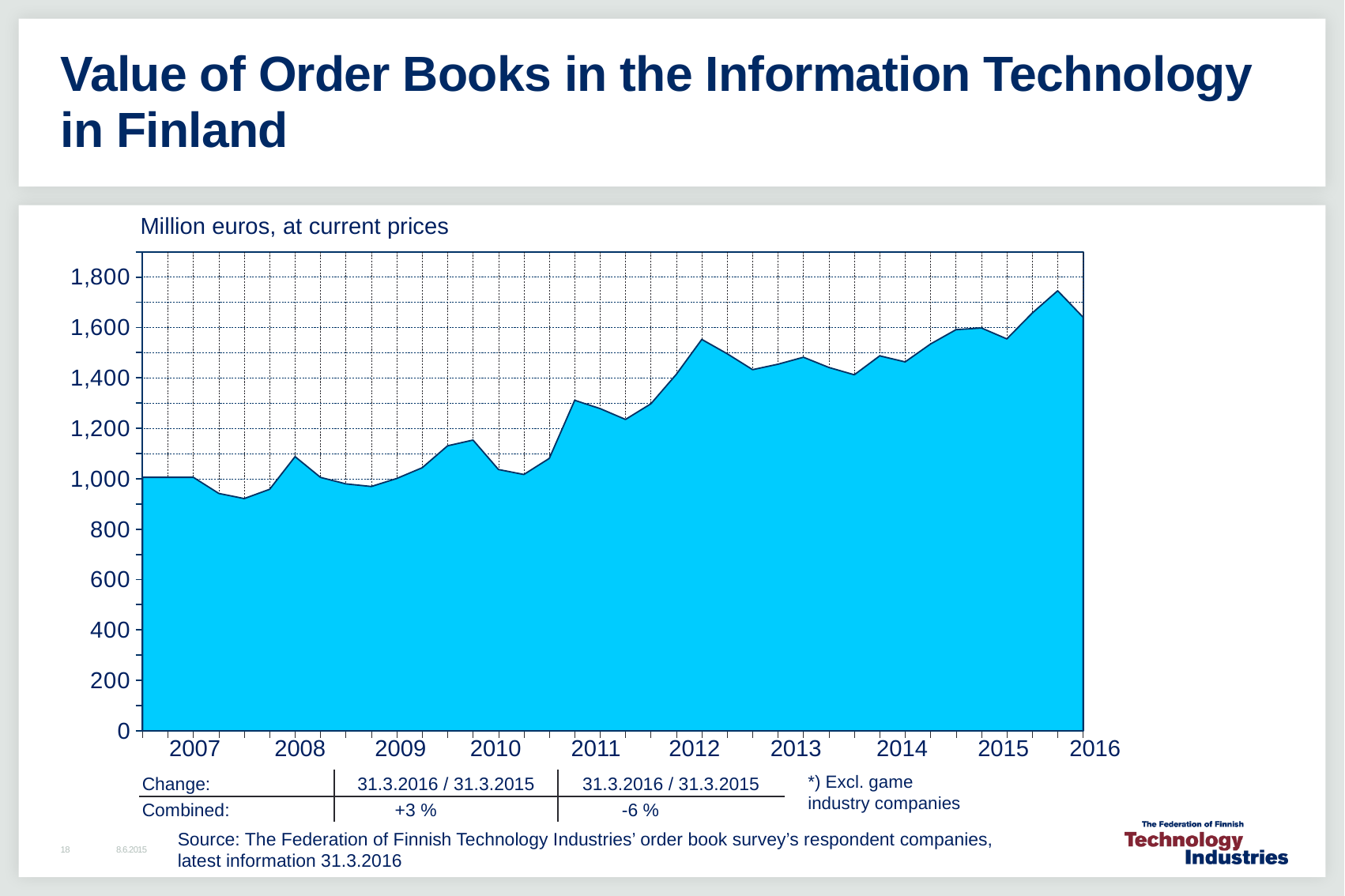
How many year labels are shown on the x axis? 10 Is the value at the start of 2016 greater or less than 1,400? greater What is the combined change for 31.3.2016 / 31.3.2015 shown in the first column below the chart? +3 % Which is larger, the value at the start of 2012 or the value at the start of 2008? 2012 What unit is stated above the chart? Million euros, at current prices Is the value at the start of 2012 greater or less than 1,200? greater Is the value at the start of 2007 greater or less than 1,200? less Overall, do the values rise or fall from 2007 to 2016? rise What kind of chart is shown on the slide? area chart In which year does the series reach its highest value? 2015